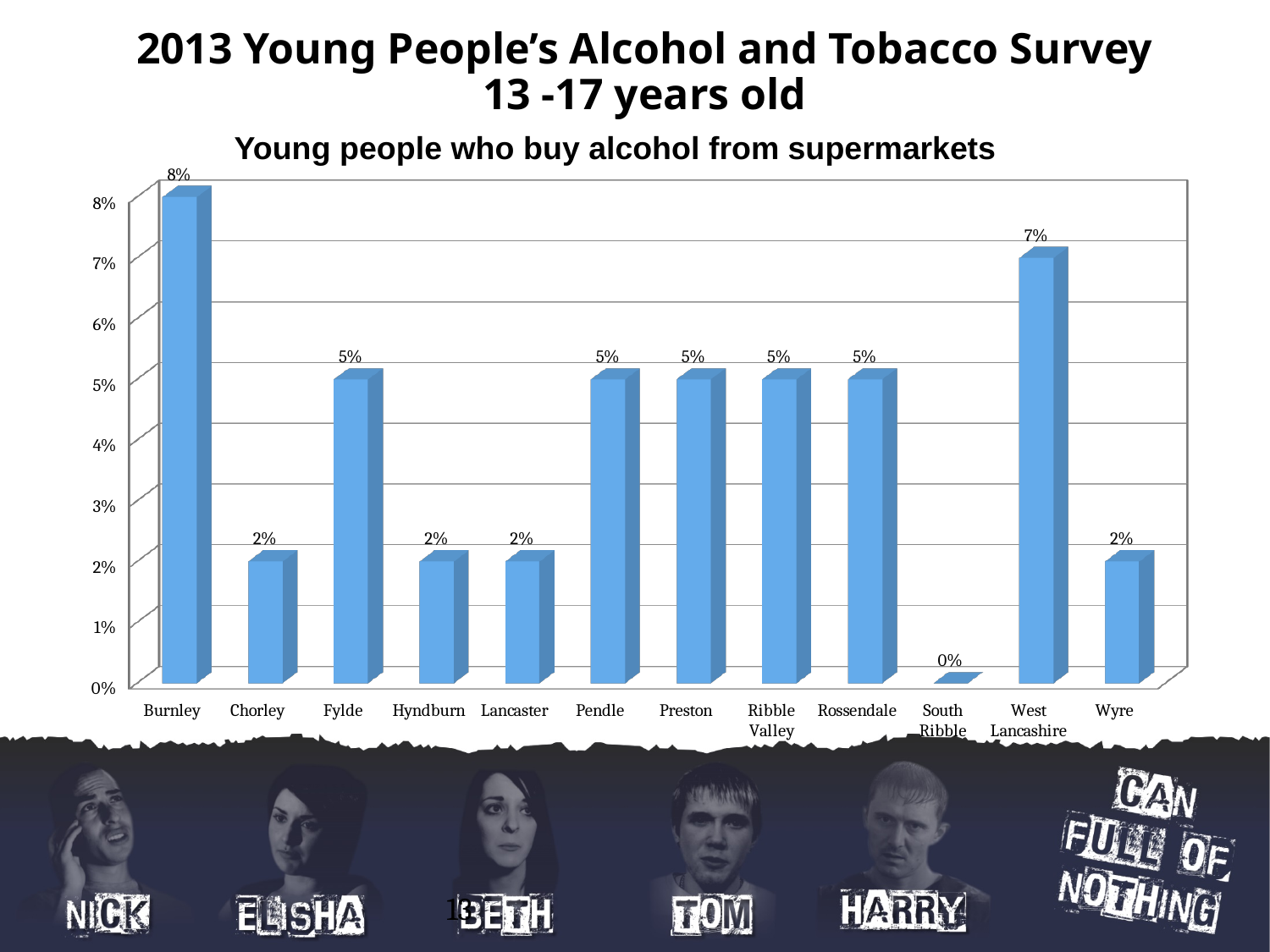
What is the difference between the values for Burnley and Chorley? 6% What kind of chart is this? Bar chart How many categories are shown on the x axis? 12 Which is larger, the value for Fylde or the value for Wyre? Fylde What is the value for Lancaster? 2% What is the value for Burnley? 8% Which category has the highest value? Burnley What is the difference between the values for West Lancashire and Pendle? 2% Which category has the lowest value? South Ribble What is the value for South Ribble? 0% What is the value for West Lancashire? 7% What is the title of the chart? Young people who buy alcohol from supermarkets